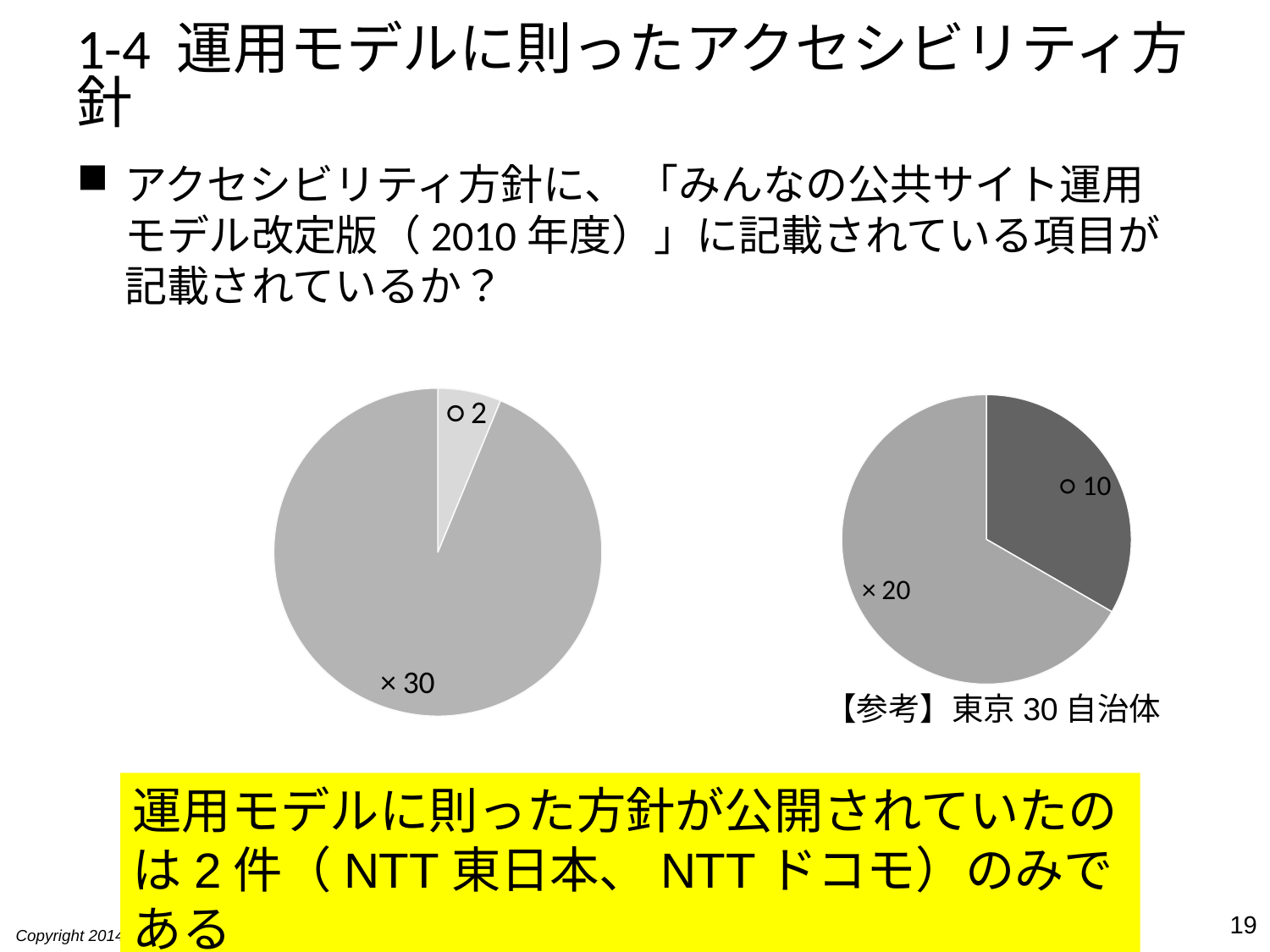
In the right pie chart (【参考】東京 30 自治体), which category has the smallest slice? ○ In the right pie chart (【参考】東京 30 自治体), what is the difference between the × value and the ○ value? 10 In the left pie chart, what is the difference between the × value and the ○ value? 28 Which is larger in the right pie chart (【参考】東京 30 自治体): the ○ value or the × value? × In the right pie chart (【参考】東京 30 自治体), what is the value for ×? 20 In the left pie chart, what is the total of the two slice values? 32 In the right pie chart (【参考】東京 30 自治体), what is the value for ○? 10 What kind of chart is the chart on the right of the slide? Pie chart In the left pie chart, which category has the largest slice? × In the left pie chart, what is the value for ○? 2 How many slices does the left pie chart have? 2 In the left pie chart, what is the value for ×? 30